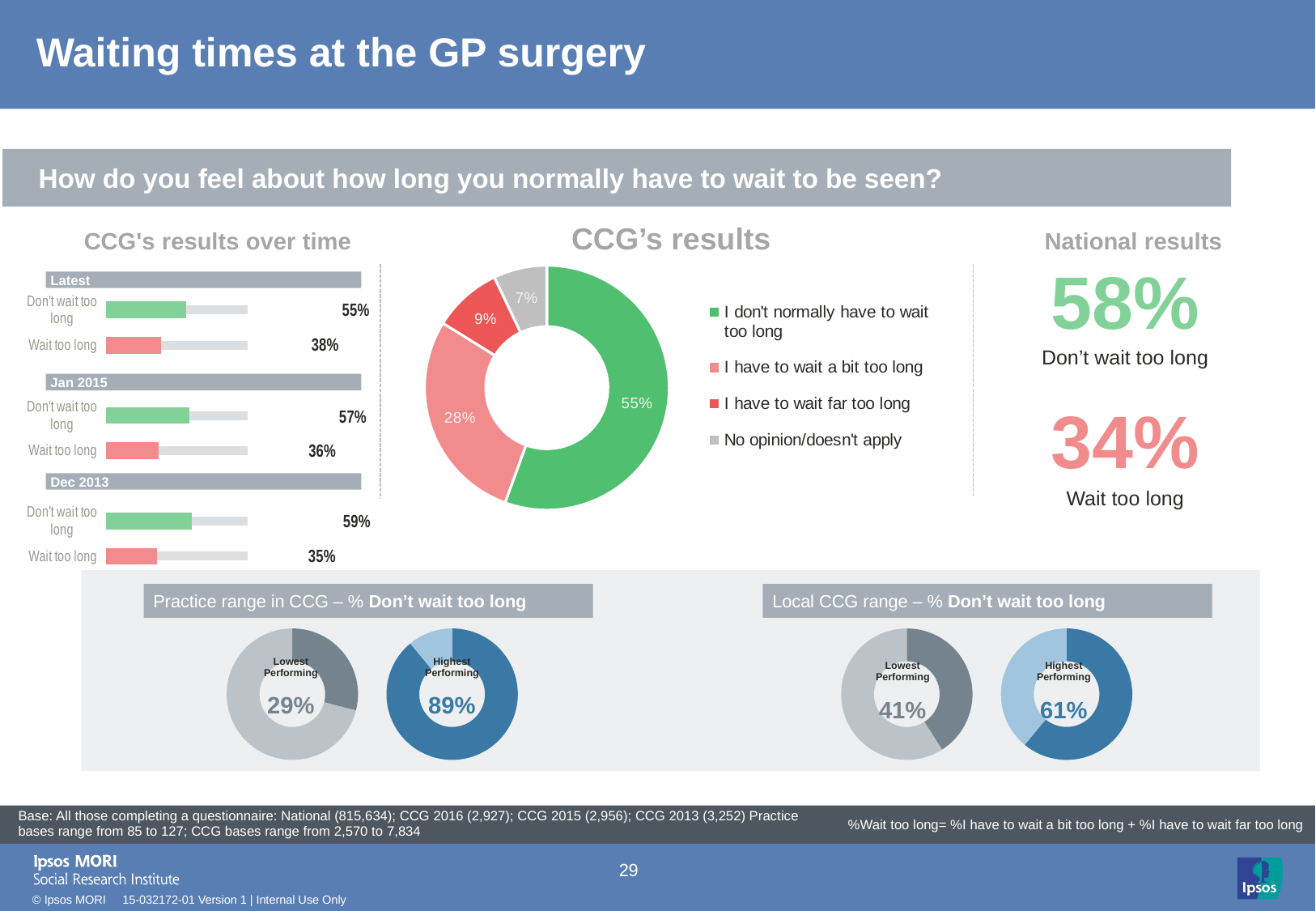
In the "Practice range in CCG – % Don't wait too long" section, what is the Highest Performing value? 89% In the "CCG's results" donut chart, what percentage of respondents said "I don't normally have to wait too long"? 55% How many entries does the legend of the "CCG's results" donut chart list? 4 In the "CCG's results over time" bar chart, what is the "Don't wait too long" value for Jan 2015? 57% In the "CCG's results" donut chart, what percentage said "I have to wait far too long"? 9% What kind of chart is the "CCG's results" chart in the centre of the slide? Donut (pie) chart In the "CCG's results" donut chart, which response has the smallest share? No opinion/doesn't apply In the "CCG's results" donut chart, what percentage said "I have to wait a bit too long"? 28% In the "CCG's results over time" bar chart, what is the difference between the Latest "Don't wait too long" value and the Latest "Wait too long" value? 17 percentage points In the "Local CCG range – % Don't wait too long" section, what is the Lowest Performing value? 41% In the "CCG's results over time" bar chart, what is the "Wait too long" value for Dec 2013? 35% In the "CCG's results over time" bar chart, how does the "Don't wait too long" value change from Dec 2013 to Latest? It falls (59% to 55%)